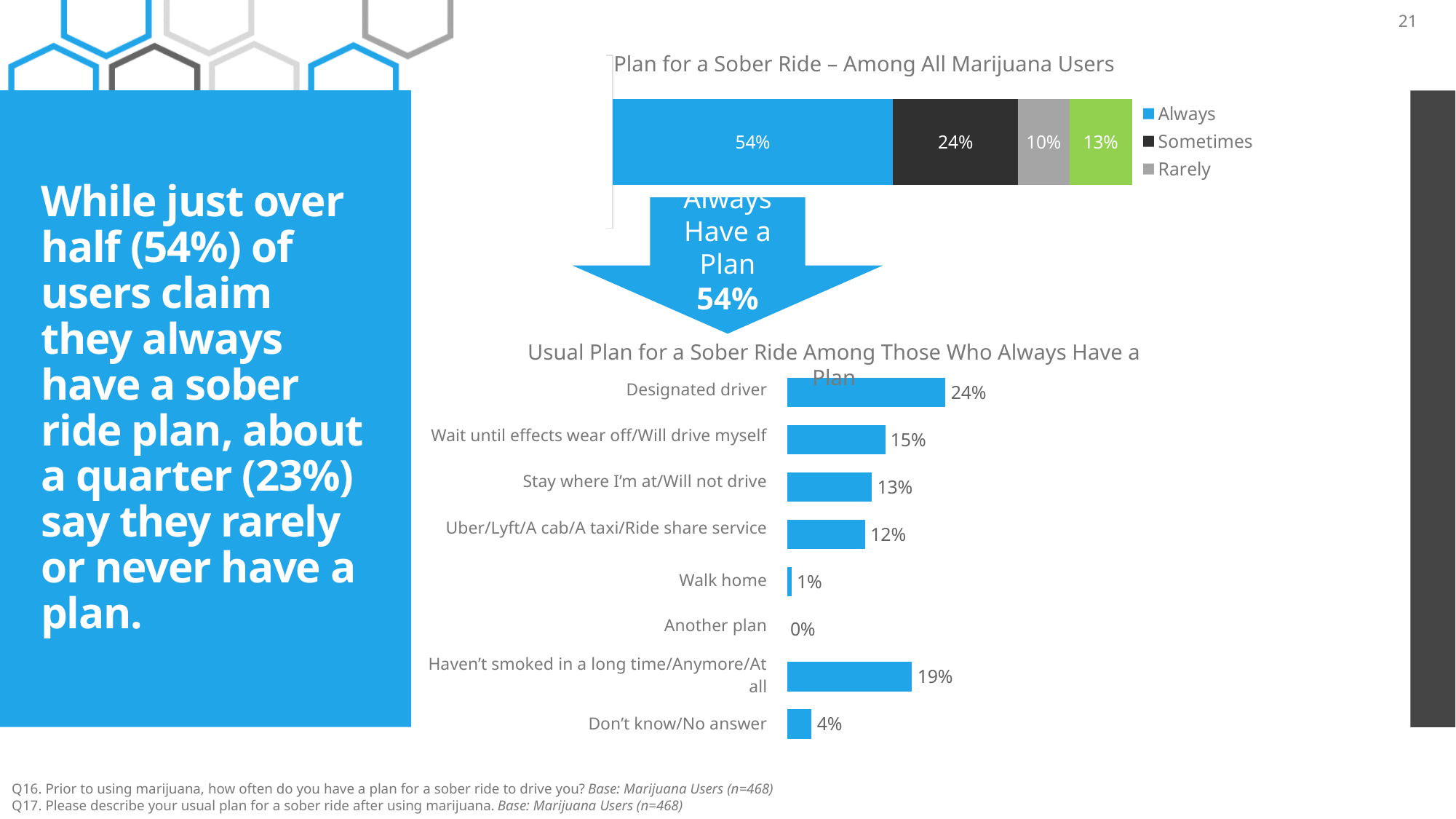
In the 'Plan for a Sober Ride – Among All Marijuana Users' chart, what is the difference between the Always and Sometimes percentages? 30% In the 'Usual Plan for a Sober Ride Among Those Who Always Have a Plan' chart, which category has the highest value? Designated driver In the 'Plan for a Sober Ride – Among All Marijuana Users' chart, what percentage is shown for Rarely? 10% In the 'Plan for a Sober Ride – Among All Marijuana Users' chart, what percentage is shown for Always? 54% In the 'Usual Plan for a Sober Ride Among Those Who Always Have a Plan' chart, what is the difference between Designated driver and Stay where I'm at/Will not drive? 11% In the 'Usual Plan for a Sober Ride Among Those Who Always Have a Plan' chart, how many categories are shown? 8 In the 'Usual Plan for a Sober Ride Among Those Who Always Have a Plan' chart, what percentage is shown for Designated driver? 24% In the 'Usual Plan for a Sober Ride Among Those Who Always Have a Plan' chart, which is larger: Wait until effects wear off/Will drive myself or Uber/Lyft/A cab/A taxi/Ride share service? Wait until effects wear off/Will drive myself In the 'Usual Plan for a Sober Ride Among Those Who Always Have a Plan' chart, what percentage is shown for Haven't smoked in a long time/Anymore/At all? 19% In the 'Plan for a Sober Ride – Among All Marijuana Users' chart, what percentage is shown for Sometimes? 24% In the 'Usual Plan for a Sober Ride Among Those Who Always Have a Plan' chart, which category has the lowest value? Another plan What kind of chart is the 'Usual Plan for a Sober Ride Among Those Who Always Have a Plan' chart? Bar chart